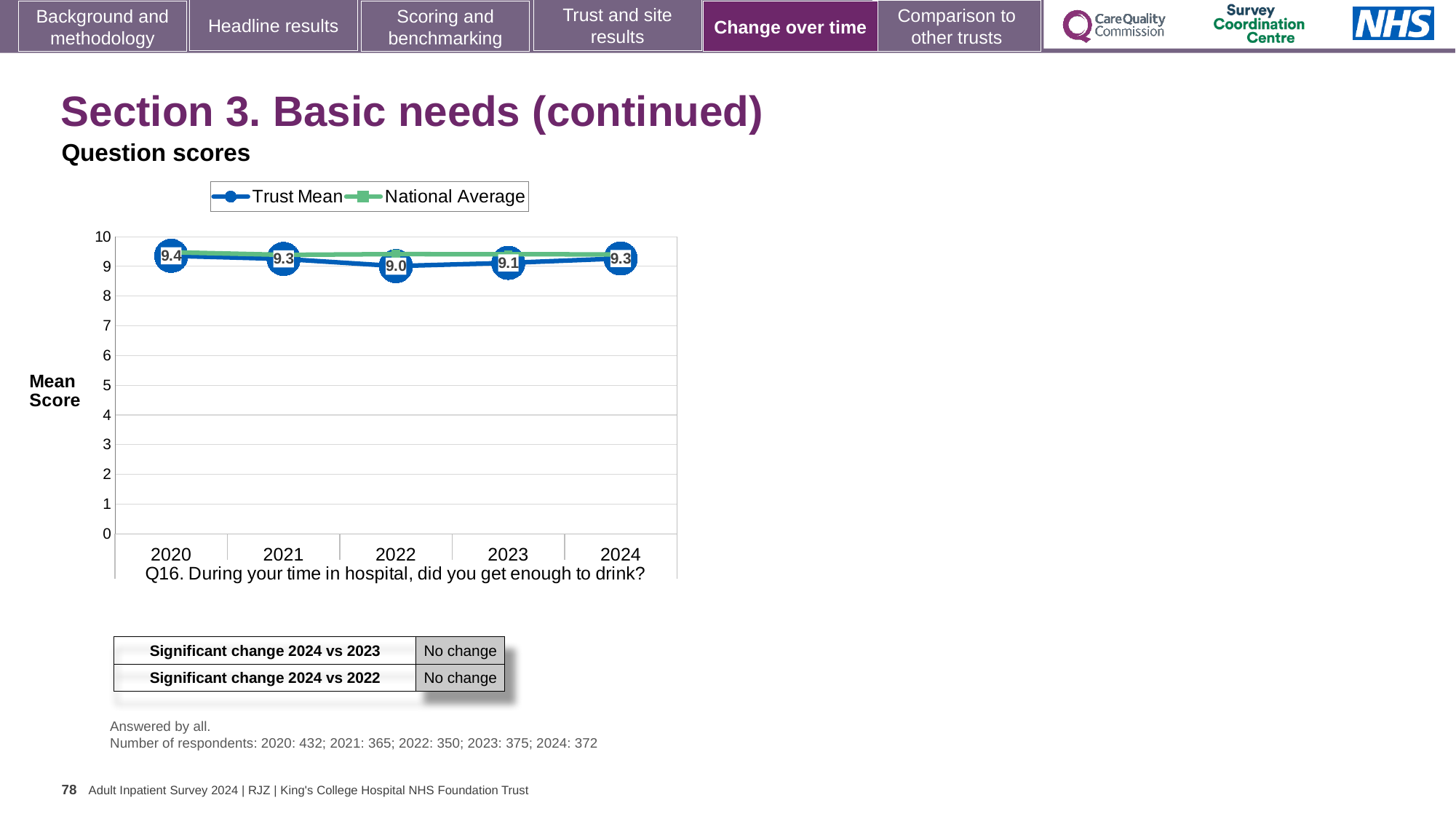
How many series does the legend list? 2 How many years are plotted on the x axis? 5 What is the Trust Mean score for 2020? 9.4 What is the Trust Mean score for 2024? 9.3 What kind of chart is shown on the slide? Line chart Is the National Average value for 2024 greater or less than 8? greater Does the Trust Mean score rise or fall from 2022 to 2024? Rise What is the Trust Mean score for 2022? 9.0 What is the difference between the Trust Mean scores for 2020 and 2022? 0.4 In which year is the Trust Mean score highest? 2020 In which year is the Trust Mean score lowest? 2022 Which year has the larger Trust Mean score, 2022 or 2023? 2023